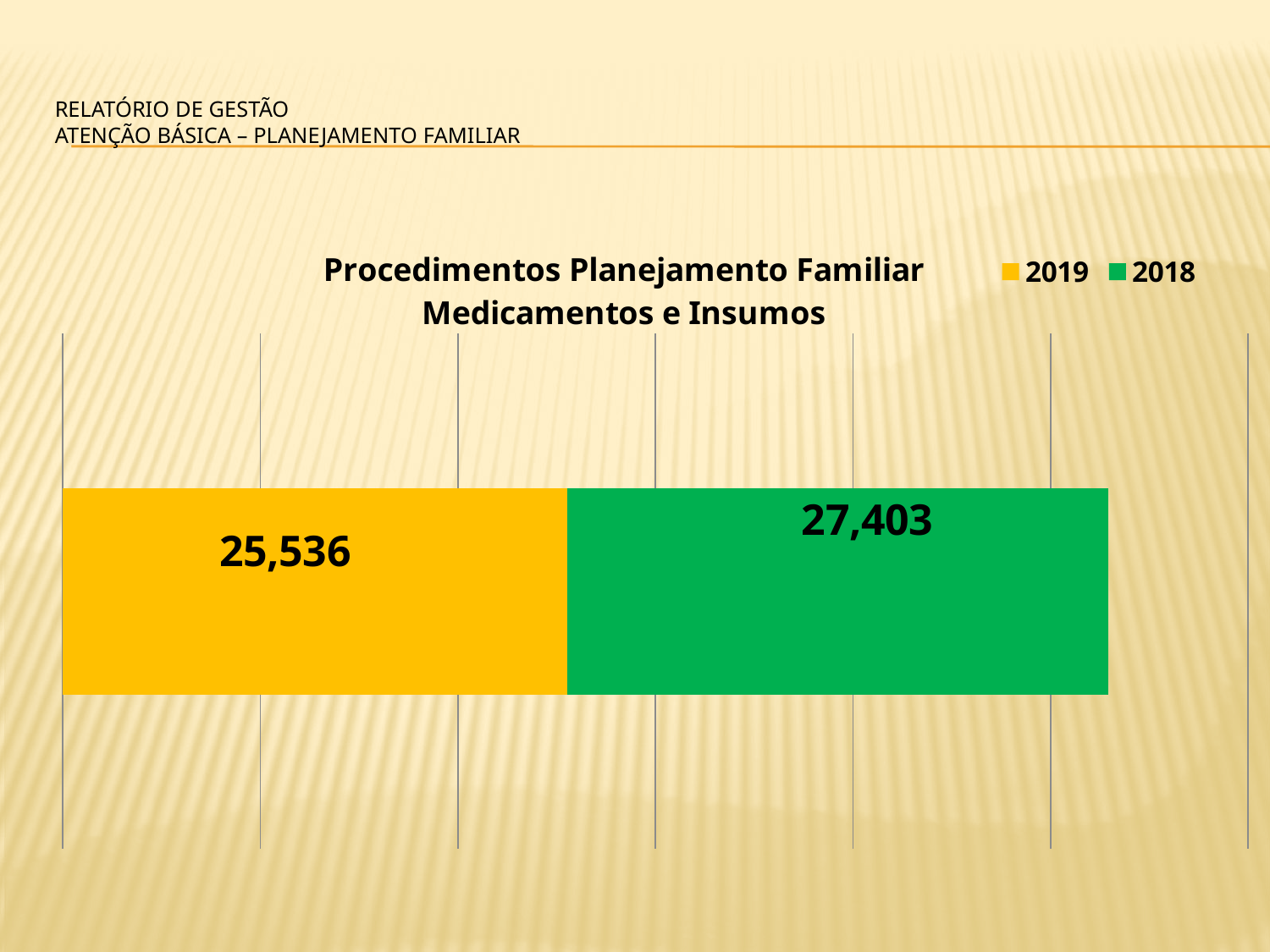
What kind of chart is shown on the slide? Bar chart Which year has the larger value, 2019 or 2018? 2018 What is the difference between the 2018 value and the 2019 value? 1,867 What is the title of the chart? Procedimentos Planejamento Familiar Medicamentos e Insumos How many series does the legend list? 2 What is the value for 2018 in the chart? 27,403 Which colour represents the 2019 series in the chart? Yellow Which series has the highest value in the chart? 2018 What is the value for 2019 in the chart? 25,536 What is the total of the stacked bar (2019 plus 2018)? 52,939 Which series has the lowest value in the chart? 2019